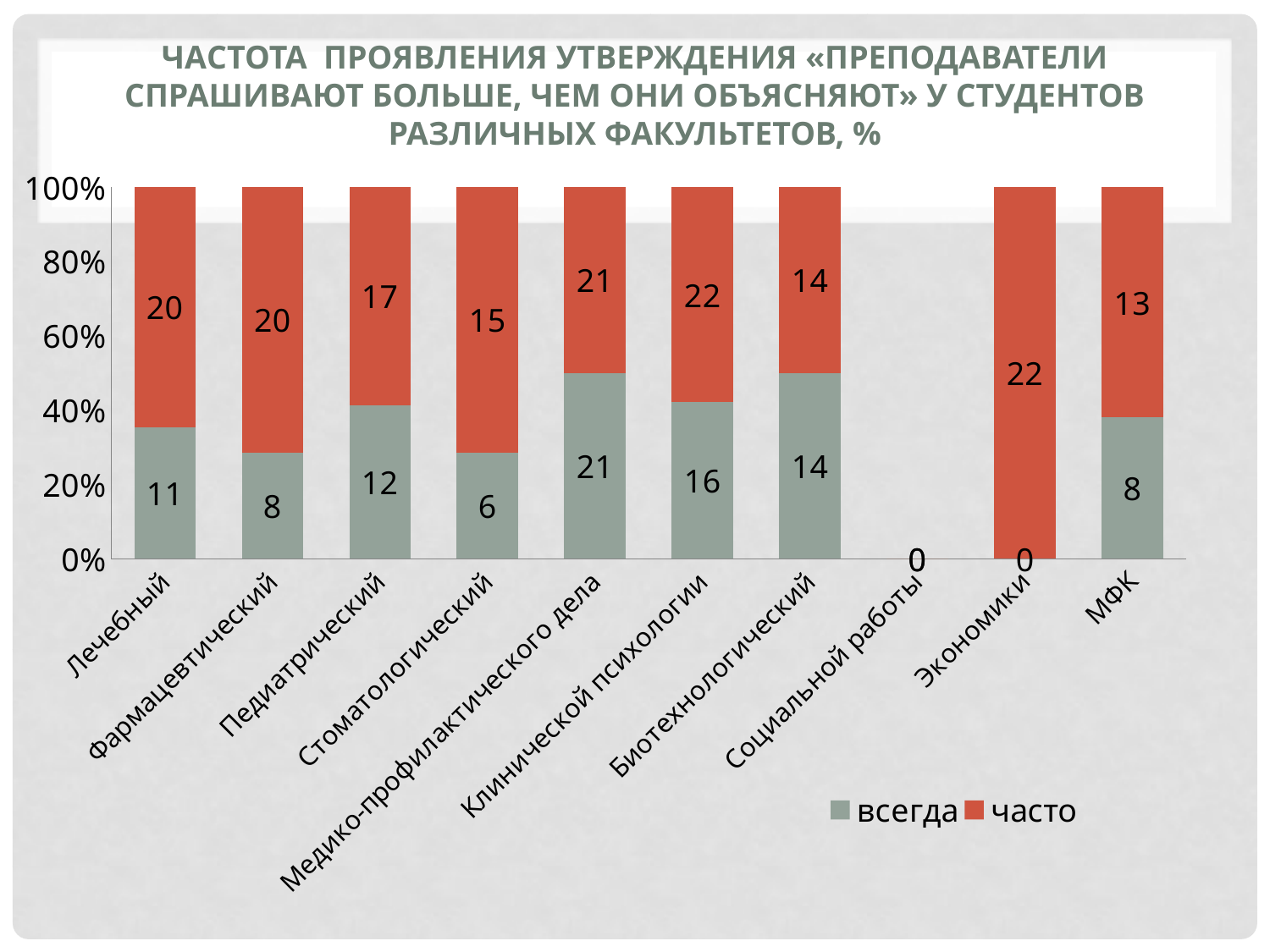
What is the difference between the «часто» and «всегда» values for Клинической психологии? 6 What is the value of the «часто» series for Экономики? 22 How many faculties are shown on the x axis? 10 What are the two entries in the legend? всегда, часто How many series does the legend list? 2 What is the value of the «всегда» series for МФК? 8 What is the value of the «всегда» series for Лечебный? 11 What kind of chart is shown on the slide? Stacked bar chart Which has the larger «всегда» value, Педиатрический or Фармацевтический? Педиатрический What is the value of the «часто» series for Стоматологический? 15 What is the difference between the «часто» and «всегда» values for Лечебный? 9 Which faculty has the highest «всегда» value? Медико-профилактического дела